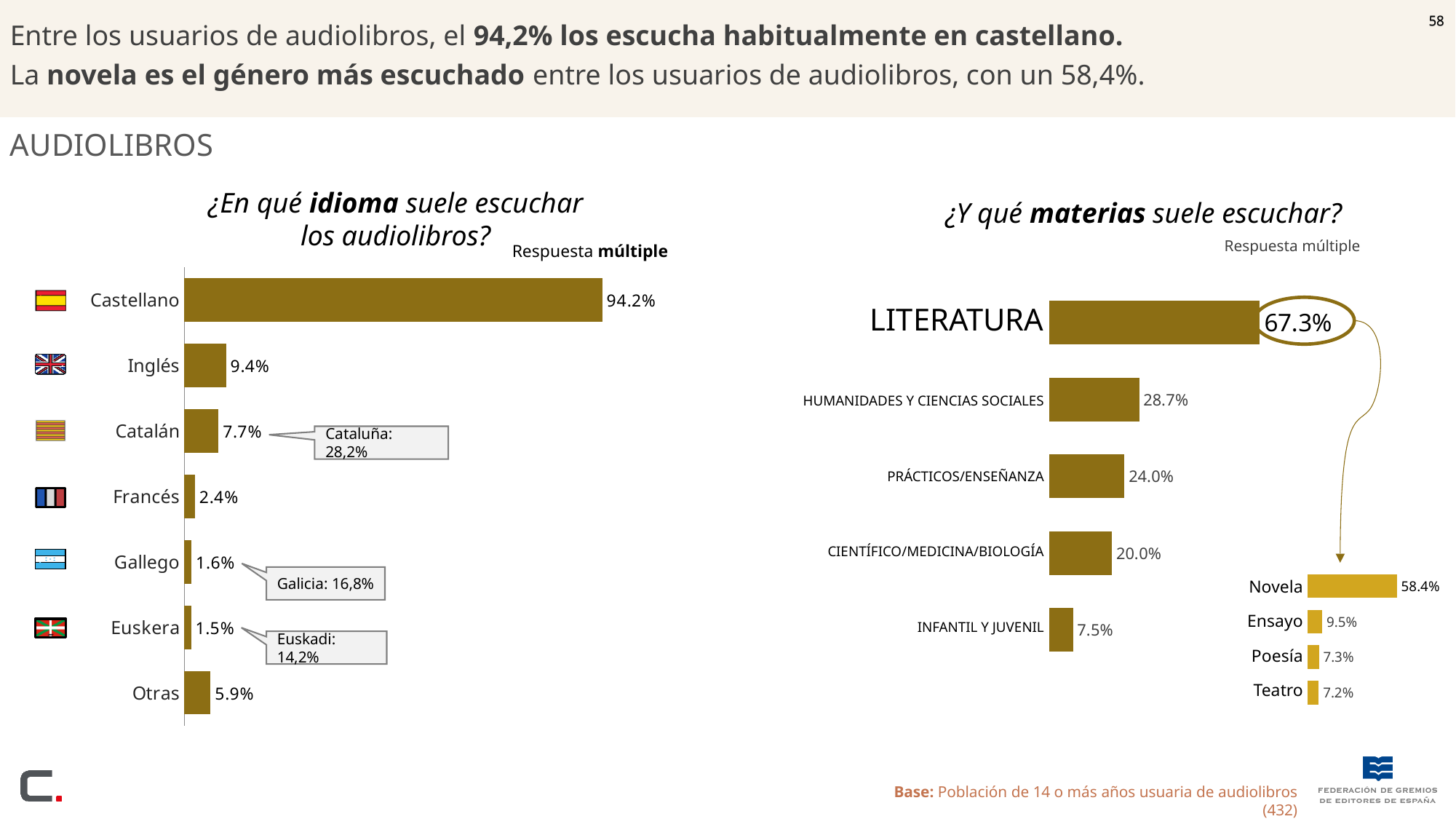
In the chart '¿En qué idioma suele escuchar los audiolibros?', how many categories are shown? 7 In the chart '¿Y qué materias suele escuchar?', what is the value for INFANTIL Y JUVENIL? 7.5% What kind of chart is '¿Y qué materias suele escuchar?'? Bar chart In the chart '¿En qué idioma suele escuchar los audiolibros?', what is the value for Castellano? 94.2% In the chart '¿En qué idioma suele escuchar los audiolibros?', which is larger, Otras or Gallego? Otras In the chart '¿Y qué materias suele escuchar?', which category has the highest value? LITERATURA In the chart '¿Y qué materias suele escuchar?', what is the value for HUMANIDADES Y CIENCIAS SOCIALES? 28.7% In the small breakdown of LITERATURA on the right, what is the value for Novela? 58.4% In the chart '¿En qué idioma suele escuchar los audiolibros?', what is the value for Inglés? 9.4% In the chart '¿Y qué materias suele escuchar?', what is the difference between PRÁCTICOS/ENSEÑANZA and CIENTÍFICO/MEDICINA/BIOLOGÍA? 4.0% In the chart '¿En qué idioma suele escuchar los audiolibros?', which language has the lowest value? Euskera In the chart '¿En qué idioma suele escuchar los audiolibros?', what is the difference between Catalán and Francés? 5.3%